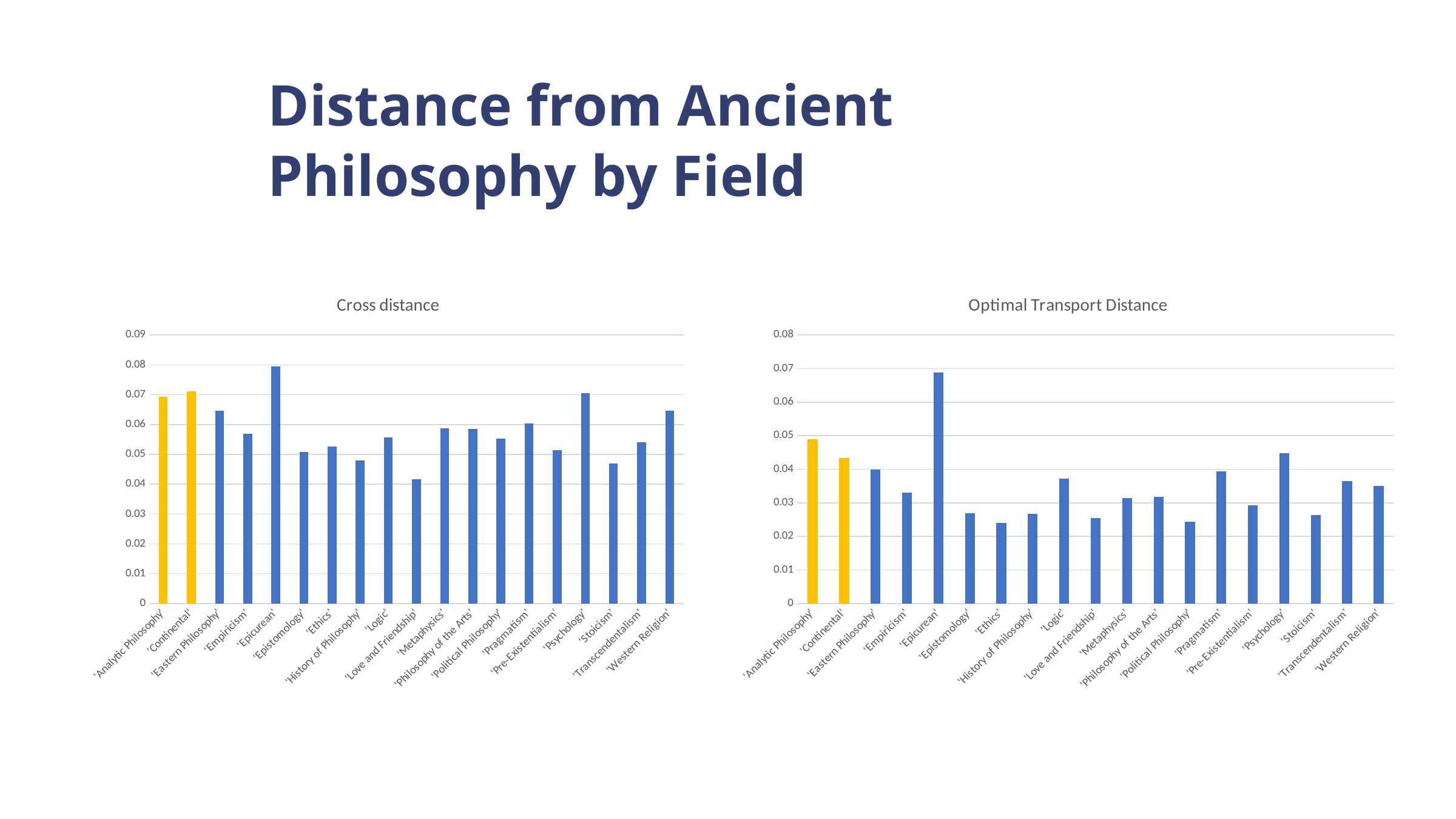
In the "Optimal Transport Distance" chart, which is larger, the value for 'Analytic Philosophy' or the value for 'Continental'? 'Analytic Philosophy' In the "Cross distance" chart, is the value for 'Love and Friendship' greater or less than 0.05? less In the "Cross distance" chart, which field has the lowest value? 'Love and Friendship' In the "Cross distance" chart, which field has the highest value? 'Epicurean' Which two fields are highlighted in yellow in the "Optimal Transport Distance" chart? 'Analytic Philosophy' and 'Continental' How many categories are shown on the x axis of the "Optimal Transport Distance" chart? 19 In the "Optimal Transport Distance" chart, which field has the highest value? 'Epicurean' In the "Optimal Transport Distance" chart, is the value for 'Ethics' greater or less than 0.03? less In the "Optimal Transport Distance" chart, is the value for 'Epicurean' greater or less than 0.06? greater What kind of chart is the "Cross distance" chart? bar chart In the "Cross distance" chart, which is larger, the value for 'Epicurean' or the value for 'Psychology'? 'Epicurean'